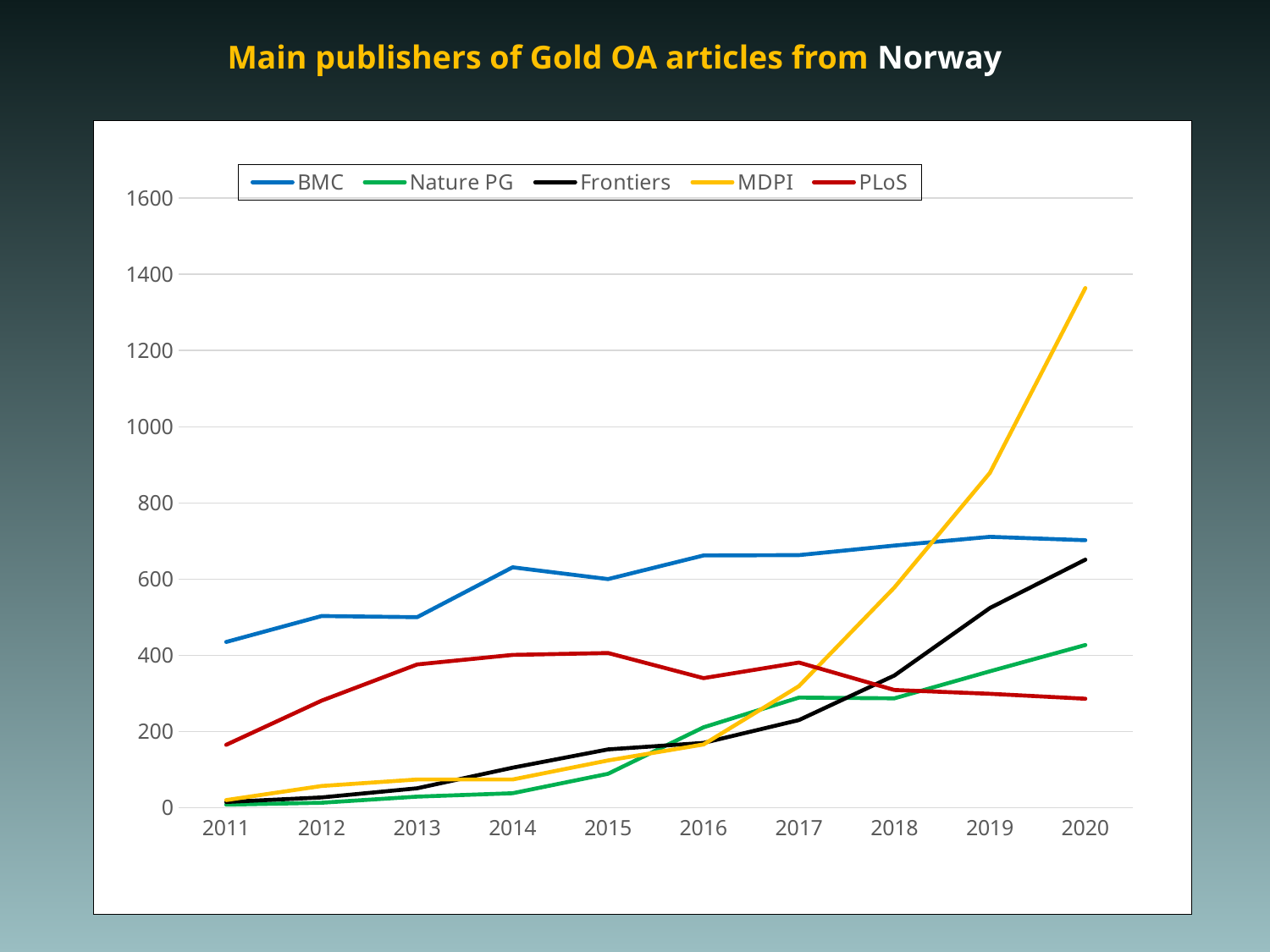
Which publisher has the lowest value in 2011? Nature PG What kind of chart is shown on the slide? line chart Is the value for PLoS in 2020 greater or less than 400? less In 2020, which is larger: the value for Frontiers or the value for Nature PG? Frontiers Is the value for BMC in 2011 greater or less than 400? greater Which publisher has the highest value in 2020? MDPI Is the value for MDPI in 2020 greater or less than 1200? greater What colour is the line for Frontiers? black In 2015, which is larger: the value for PLoS or the value for MDPI? PLoS How many series does the legend list? 5 How many years are shown on the x axis? 10 Does the MDPI line rise or fall from 2016 to 2020? rise